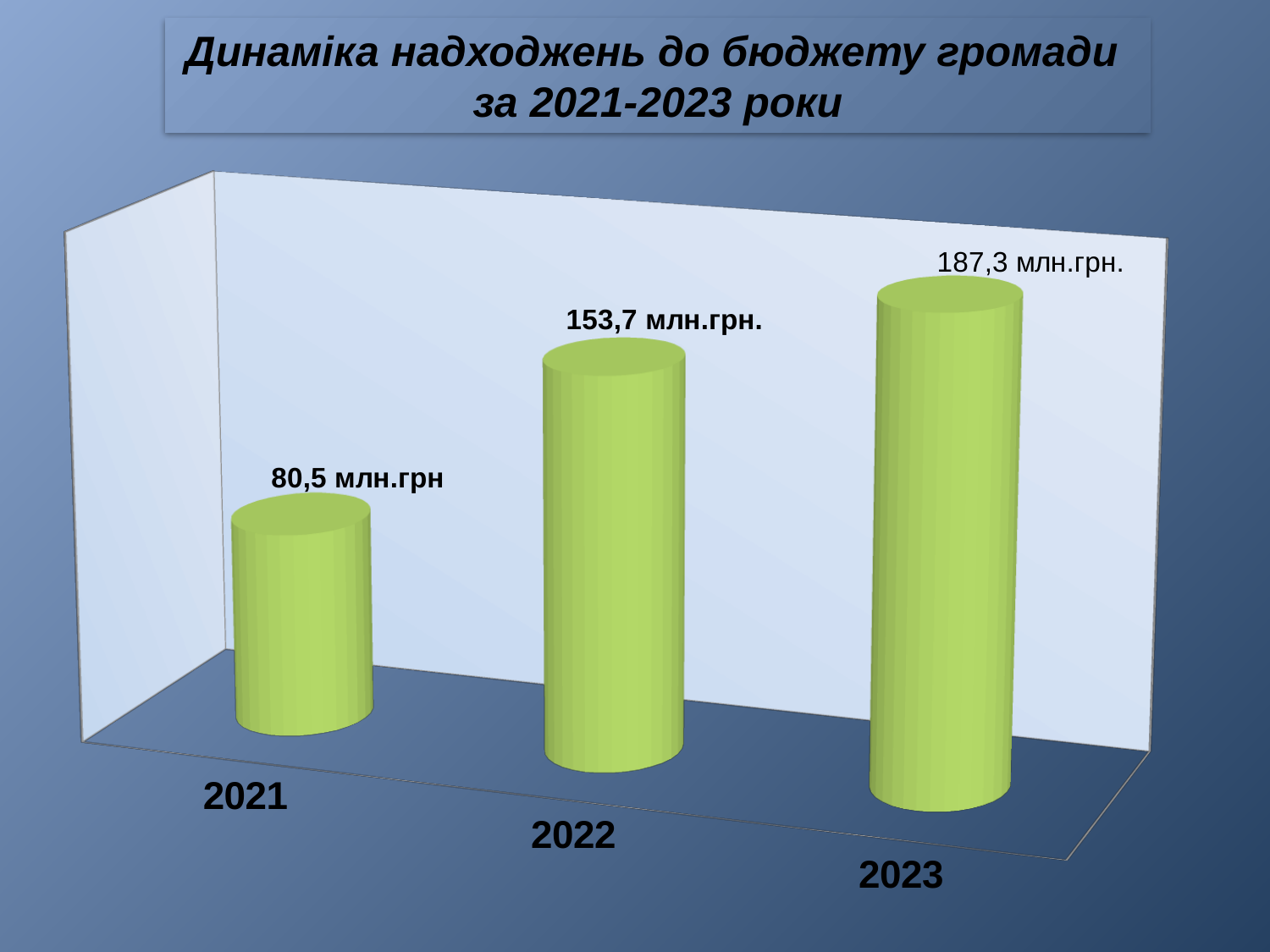
What is the difference between the values for 2023 and 2022? 33,6 млн.грн. What is the value shown for 2022? 153,7 млн.грн. What is the value shown for 2021? 80,5 млн.грн What kind of chart is shown on the slide? Bar chart Do the values rise or fall from 2021 to 2023? Rise How many years are shown on the chart? 3 What is the difference between the values for 2022 and 2021? 73,2 млн.грн. Which year has the lowest value? 2021 What is the value shown for 2023? 187,3 млн.грн. Which year has the highest value? 2023 What is the title of the slide? Динаміка надходжень до бюджету громади за 2021-2023 роки Which is larger, the value for 2021 or the value for 2022? 2022